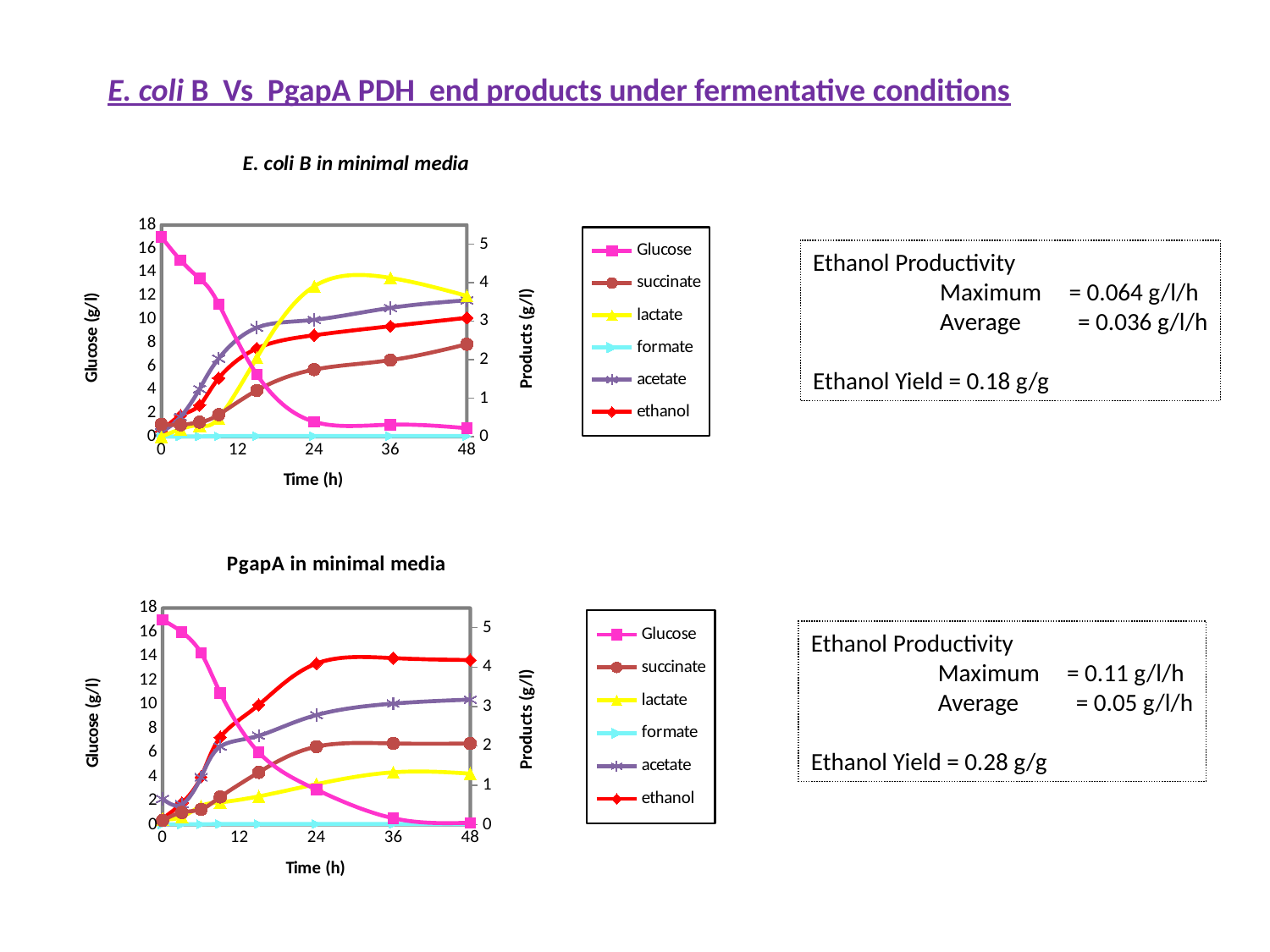
Which chart shows the higher ethanol value at 48 h, 'E. coli B in minimal media' or 'PgapA in minimal media'? PgapA in minimal media In the 'E. coli B in minimal media' chart, does the Glucose series rise or fall over time? fall In the 'PgapA in minimal media' chart, which is larger at 24 h, ethanol or lactate? ethanol In the 'PgapA in minimal media' chart, is the lactate value at 48 h greater or less than 2 g/l? less In the 'PgapA in minimal media' chart, which product series is lowest at 48 h? formate In the 'E. coli B in minimal media' chart, is the Glucose value at 0 h greater or less than 16 g/l? greater In the 'PgapA in minimal media' chart, is the ethanol value at 36 h greater or less than 3 g/l? greater In the 'E. coli B in minimal media' chart, which product series is lowest at 48 h? formate What kind of chart is the 'E. coli B in minimal media' chart? line chart How many series does the legend of the 'PgapA in minimal media' chart list? 6 In the 'PgapA in minimal media' chart, which product series is highest at 48 h? ethanol